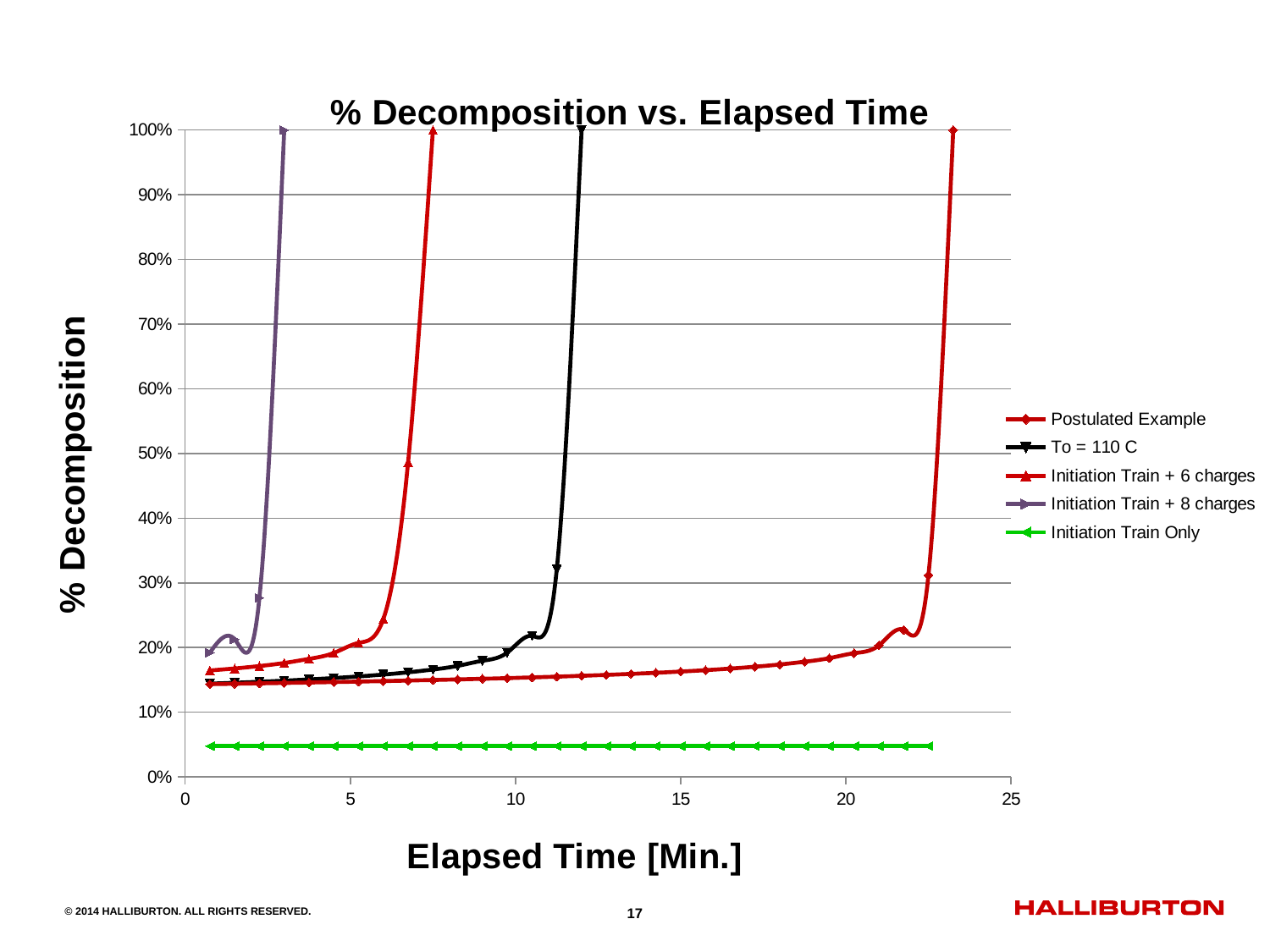
Does the Initiation Train Only series rise, fall, or stay flat as elapsed time increases? stays flat Is the elapsed time at which To = 110 C reaches 100% greater or less than 10 minutes? greater Which series reaches 100% decomposition earlier, Initiation Train + 6 charges or To = 110 C? Initiation Train + 6 charges Is the elapsed time at which Initiation Train + 8 charges reaches 100% greater or less than 5 minutes? less How many series does the legend list? 5 What kind of chart is shown on the slide? line chart Is the elapsed time at which Postulated Example reaches 100% greater or less than 20 minutes? greater What is the title of the chart? % Decomposition vs. Elapsed Time Which series reaches 100% decomposition at the earliest elapsed time? Initiation Train + 8 charges What is the label of the x axis? Elapsed Time [Min.] Which series reaches 100% decomposition at the latest elapsed time? Postulated Example